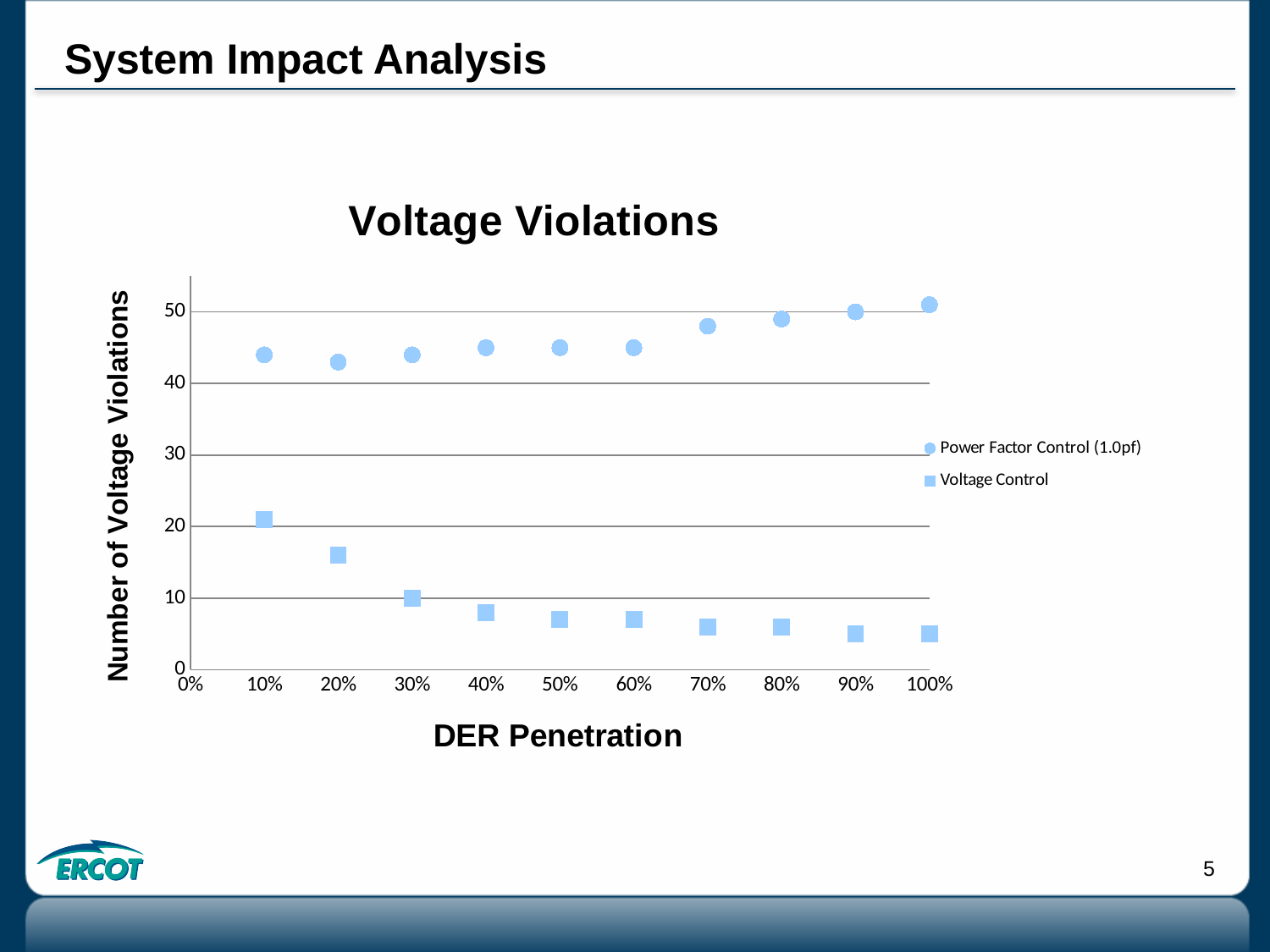
How many series does the legend list? 2 What type of chart is shown on the slide? scatter chart At which DER penetration level is the Voltage Control value highest? 10% Is the value for Power Factor Control (1.0pf) at 10% DER penetration greater or less than 40? greater How many data points are plotted for the Voltage Control series? 10 Is the value for Voltage Control at 100% DER penetration greater or less than 10? less What is the title of the chart? Voltage Violations Do the Voltage Control values rise or fall as DER penetration increases? fall What is the label of the x axis? DER Penetration At 50% DER penetration, which series has the larger value, Power Factor Control (1.0pf) or Voltage Control? Power Factor Control (1.0pf)